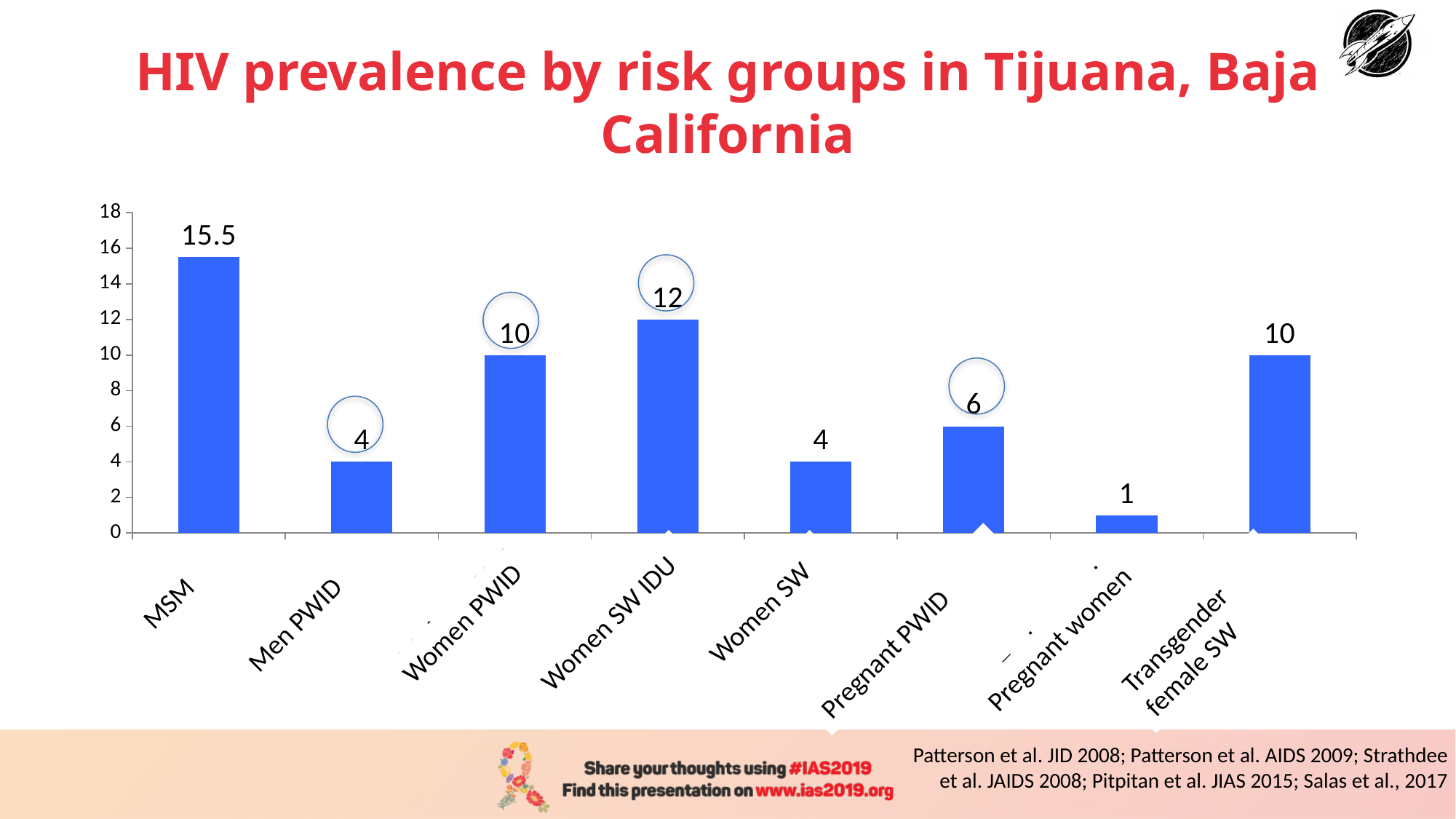
What is the value shown for Pregnant women? 1 Which risk group has the highest HIV prevalence? MSM What is the difference between the values for MSM and Women SW IDU? 3.5 What is the value shown for Women SW IDU? 12 Which risk group has the lowest HIV prevalence? Pregnant women Which is larger, the value for Women PWID or the value for Pregnant PWID? Women PWID What kind of chart is shown on the slide? Bar chart What is the difference between the values for Women SW IDU and Women SW? 8 How many risk groups are shown on the chart? 8 What is the value shown for Pregnant PWID? 6 What is the title of the chart? HIV prevalence by risk groups in Tijuana, Baja California What is the HIV prevalence value shown for MSM? 15.5